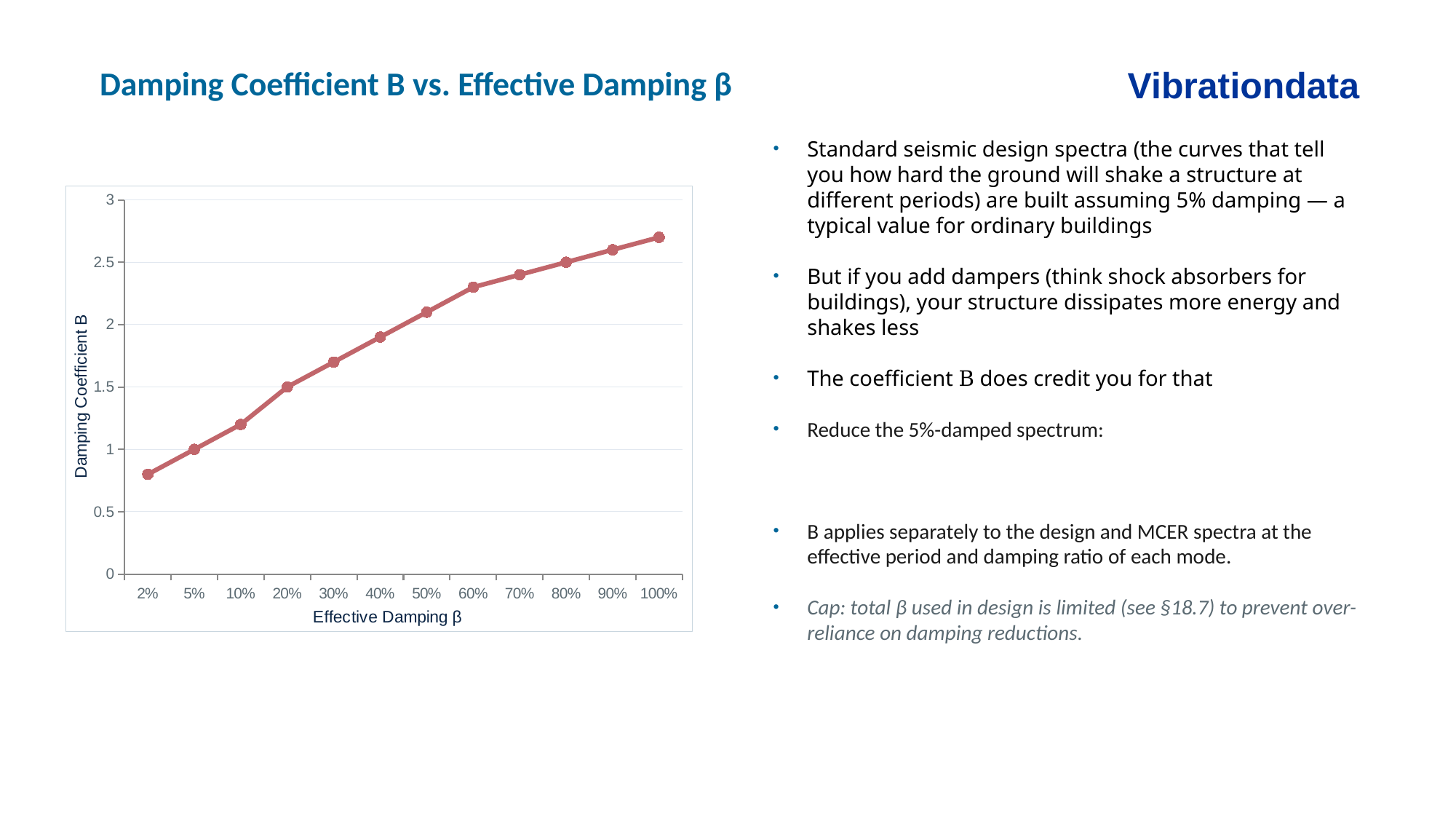
What is the Damping Coefficient B at an Effective Damping β of 5%? 1 How many data points are plotted on the chart? 12 What is the label of the x axis of the chart? Effective Damping β What is the Damping Coefficient B at an Effective Damping β of 80%? 2.5 Which has a larger Damping Coefficient B: 30% or 50% Effective Damping? 50% Which Effective Damping β category has the highest Damping Coefficient B? 100% What kind of chart is shown on the slide? line chart Is the Damping Coefficient B at 2% Effective Damping greater or less than 1? less Do the values of Damping Coefficient B rise or fall as Effective Damping β increases along the x axis? rise Which Effective Damping β category has the lowest Damping Coefficient B? 2% Is the Damping Coefficient B at 60% Effective Damping greater or less than 2? greater What is the Damping Coefficient B at an Effective Damping β of 20%? 1.5